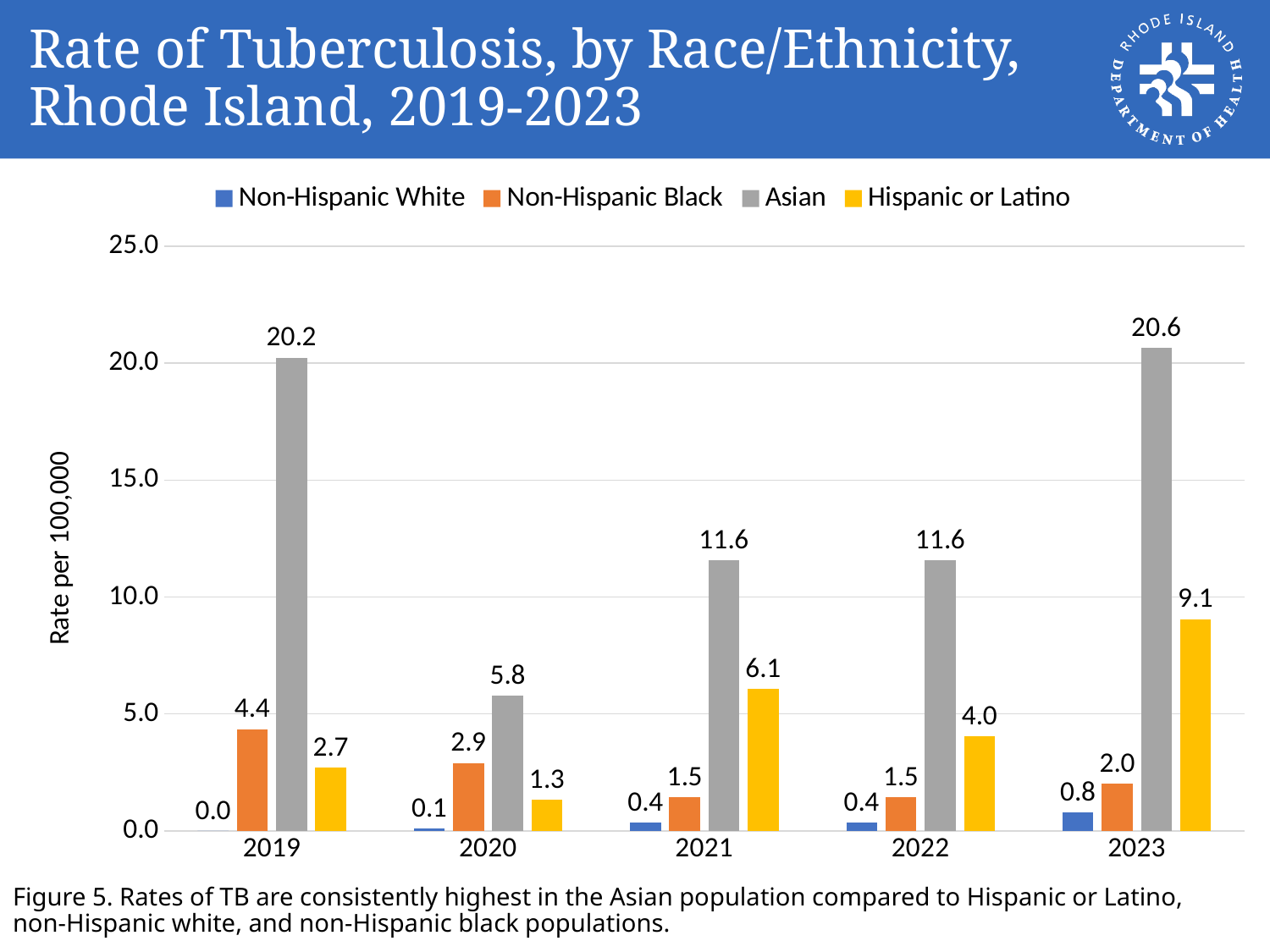
How many series does the legend list? 4 What is the label on the y axis? Rate per 100,000 What kind of chart is shown on the slide? Bar chart In which year was the Asian TB rate highest? 2023 What was the TB rate for Non-Hispanic Black residents in 2020? 2.9 What was the TB rate for Hispanic or Latino residents in 2023? 9.1 How many years are shown on the x axis? 5 What is the difference between the Asian rate and the Hispanic or Latino rate in 2023? 11.5 In which year was the Hispanic or Latino TB rate lowest? 2020 What was the TB rate for the Asian population in 2019? 20.2 Is the Asian rate in 2021 greater or less than 10.0? greater Which was larger in 2019, the Non-Hispanic Black rate or the Hispanic or Latino rate? Non-Hispanic Black